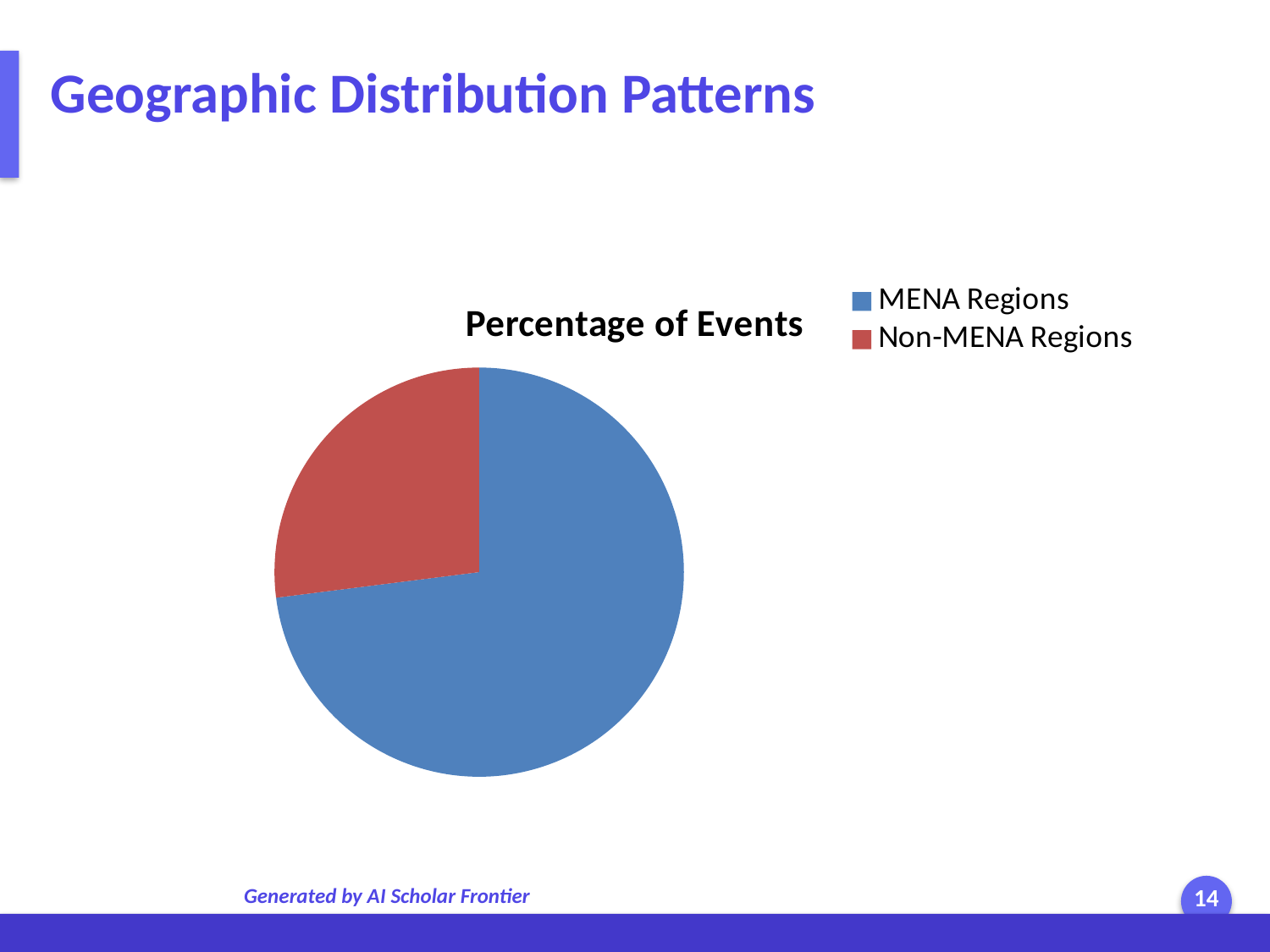
What colour is the slice for Non-MENA Regions? red Which category has the largest slice of the pie? MENA Regions How many series does the legend list? 2 Which category has the smallest slice of the pie? Non-MENA Regions What kind of chart is shown on the slide? pie chart What is the title of the chart? Percentage of Events How many slices does the pie chart have? 2 Which slice is larger, MENA Regions or Non-MENA Regions? MENA Regions